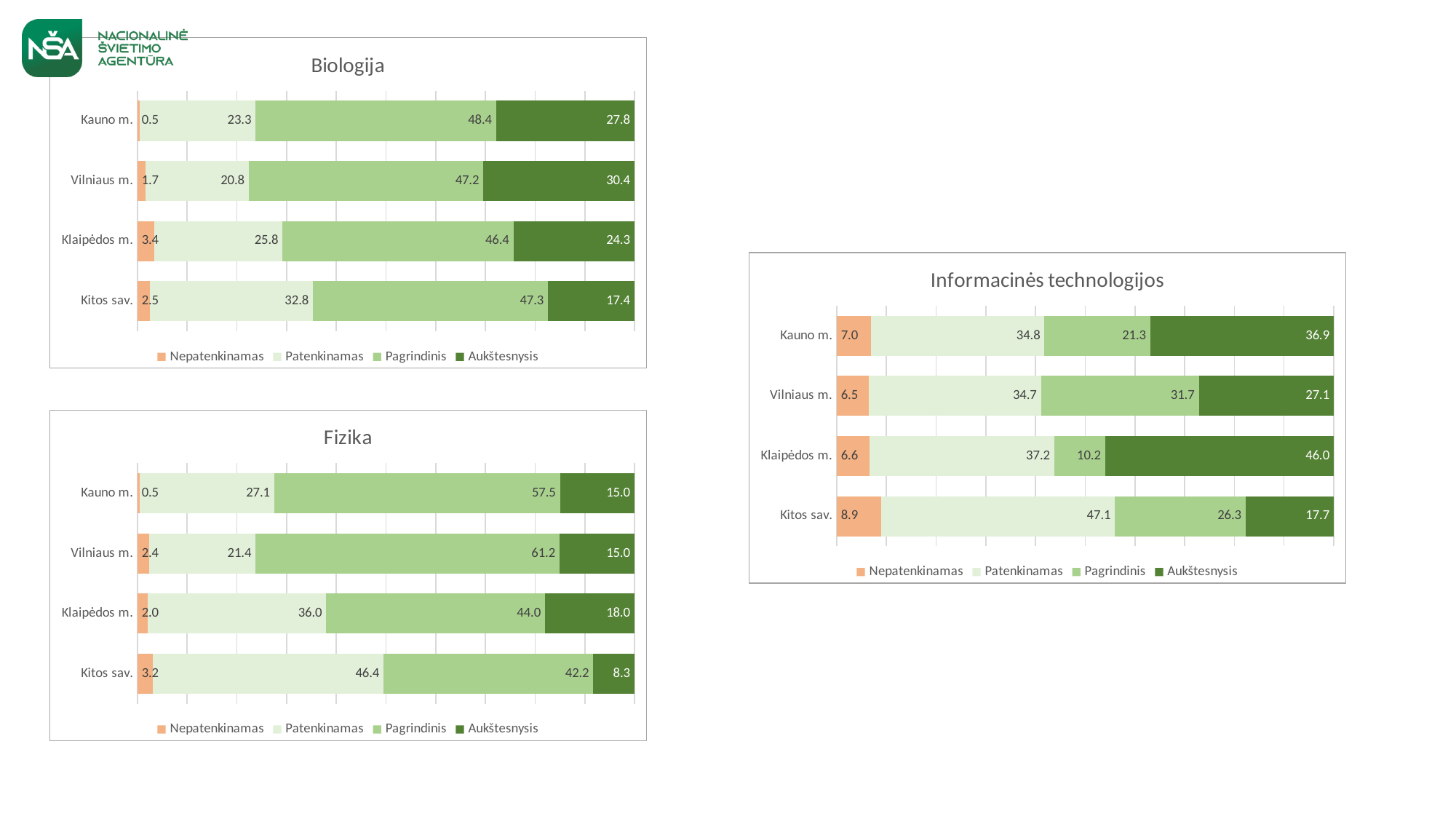
In the Biologija chart, which category has the highest Nepatenkinamas value? Klaipėdos m. In the Fizika chart, which category has the lowest Aukštesnysis value? Kitos sav. What kind of chart is the Informacinės technologijos chart? Stacked bar chart In the Informacinės technologijos chart, which category has the highest Aukštesnysis value? Klaipėdos m. In the Informacinės technologijos chart, what is the total of the stacked bar for Klaipėdos m.? 100.0 In the Informacinės technologijos chart, what is the Nepatenkinamas value for Kitos sav.? 8.9 In the Biologija chart, what is the Pagrindinis value for Kauno m.? 48.4 How many categories are shown in the Biologija chart? 4 How many series does the legend of the Fizika chart list? 4 In the Fizika chart, what is the Patenkinamas value for Klaipėdos m.? 36.0 In the Fizika chart, which is larger: the Pagrindinis value for Vilniaus m. or for Kauno m.? Vilniaus m. In the Biologija chart, what is the difference between the Aukštesnysis values for Vilniaus m. and Kauno m.? 2.6